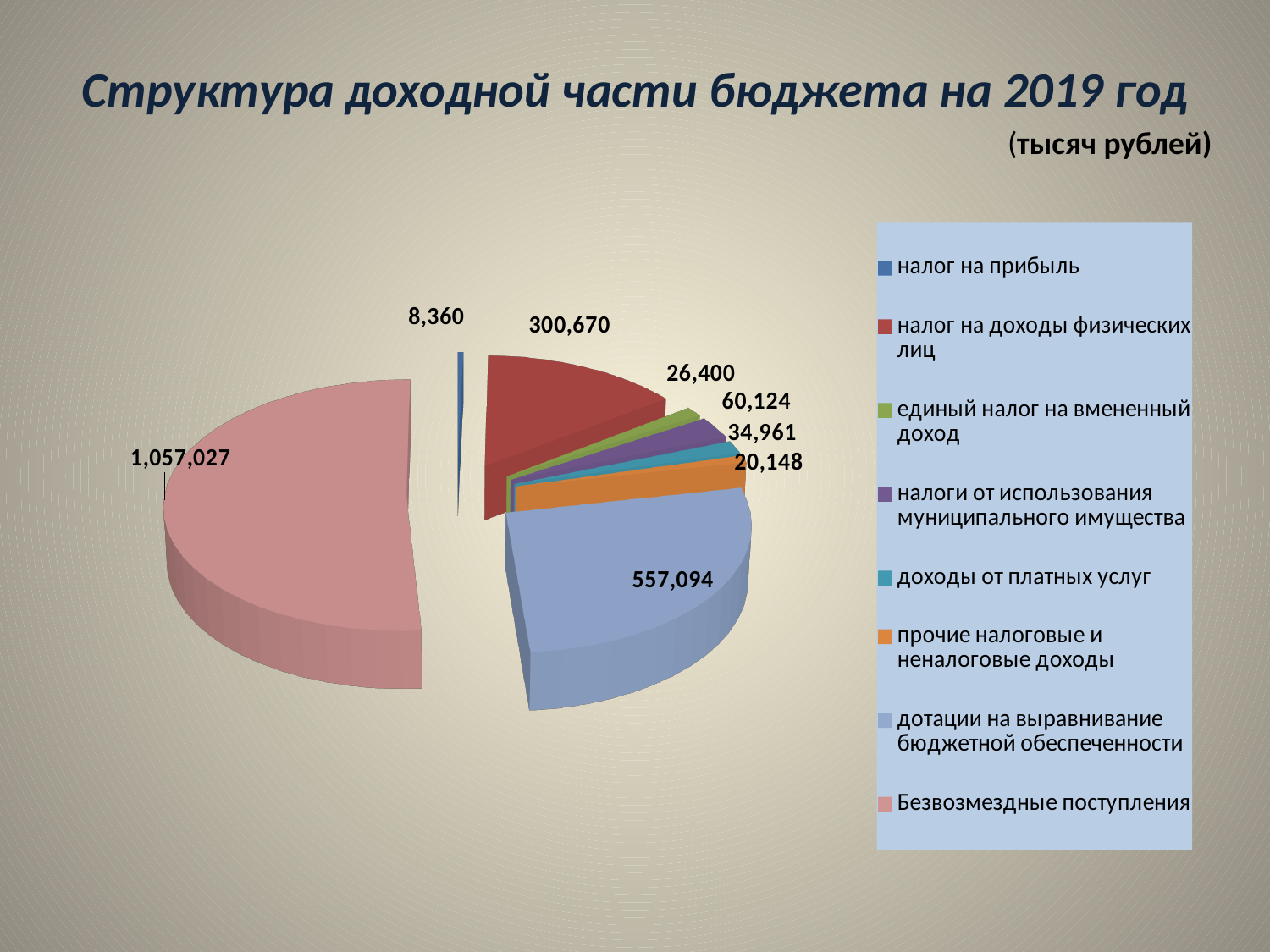
What is the value for дотации на выравнивание бюджетной обеспеченности? 557,094 Which category has the smallest slice of the pie? налог на прибыль Which is larger: единый налог на вмененный доход or прочие налоговые и неналоговые доходы? единый налог на вмененный доход What is the value for доходы от платных услуг? 34,961 What type of chart is shown on the slide? pie chart What is the value for налоги от использования муниципального имущества? 60,124 What is the value for налог на доходы физических лиц? 300,670 What is the difference between the values for дотации на выравнивание бюджетной обеспеченности and налог на доходы физических лиц? 256,424 What is the value for Безвозмездные поступления? 1,057,027 How many categories does the legend list? 8 Which category has the largest slice of the pie? Безвозмездные поступления What unit is stated under the chart title? тысяч рублей